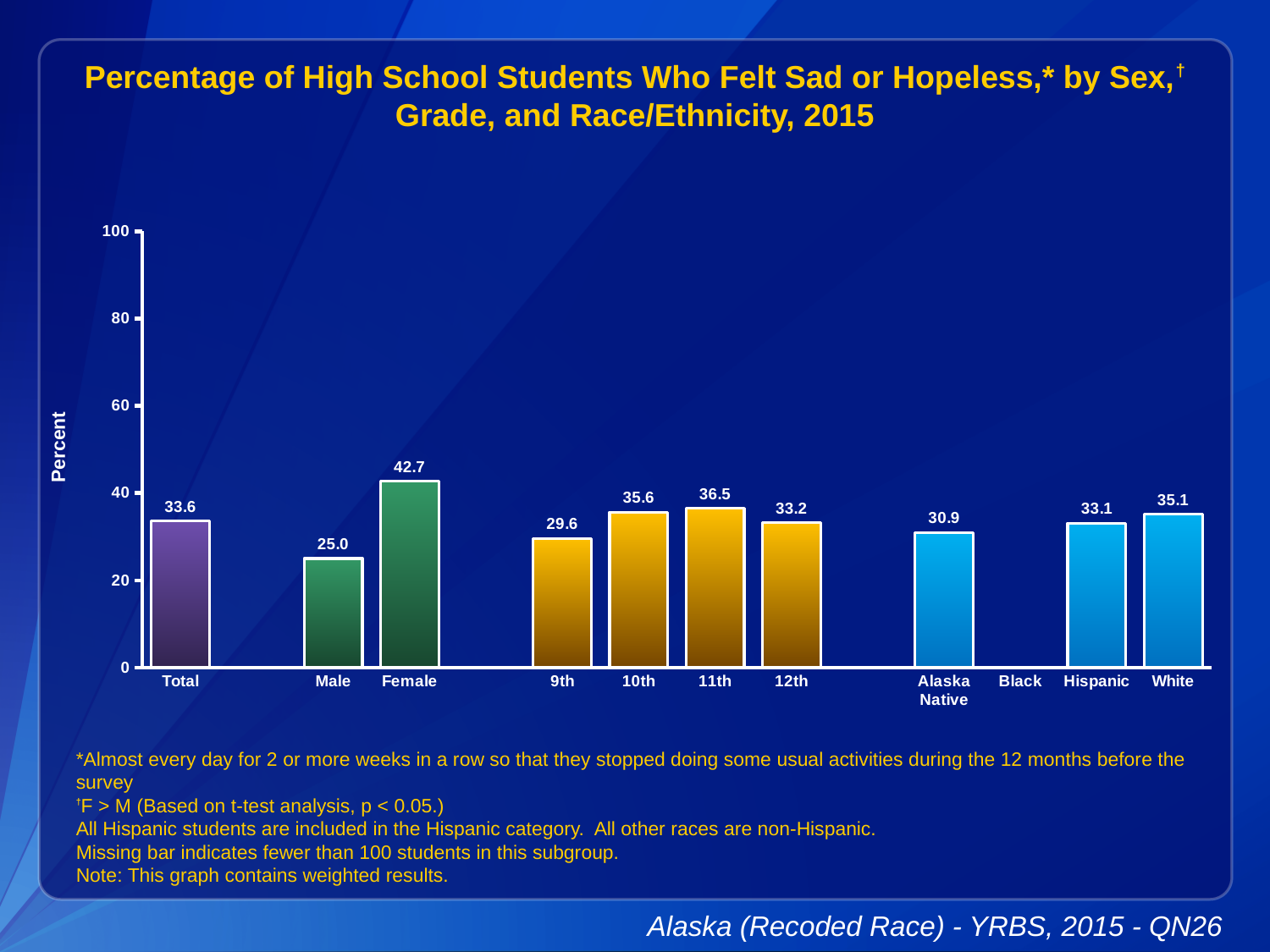
What is the value for 9th grade? 29.6 Which category has the lowest value? Male What kind of chart is shown? bar chart What is the difference between the Female and Male values? 17.7 Is the value for Total greater or less than 40? less Which category has no bar shown? Black Which is larger, the value for 11th grade or 12th grade? 11th How many bars are plotted on the chart? 10 What is the label on the y axis? Percent Which category has the highest value? Female What is the value for Female? 42.7 What is the value for Alaska Native? 30.9